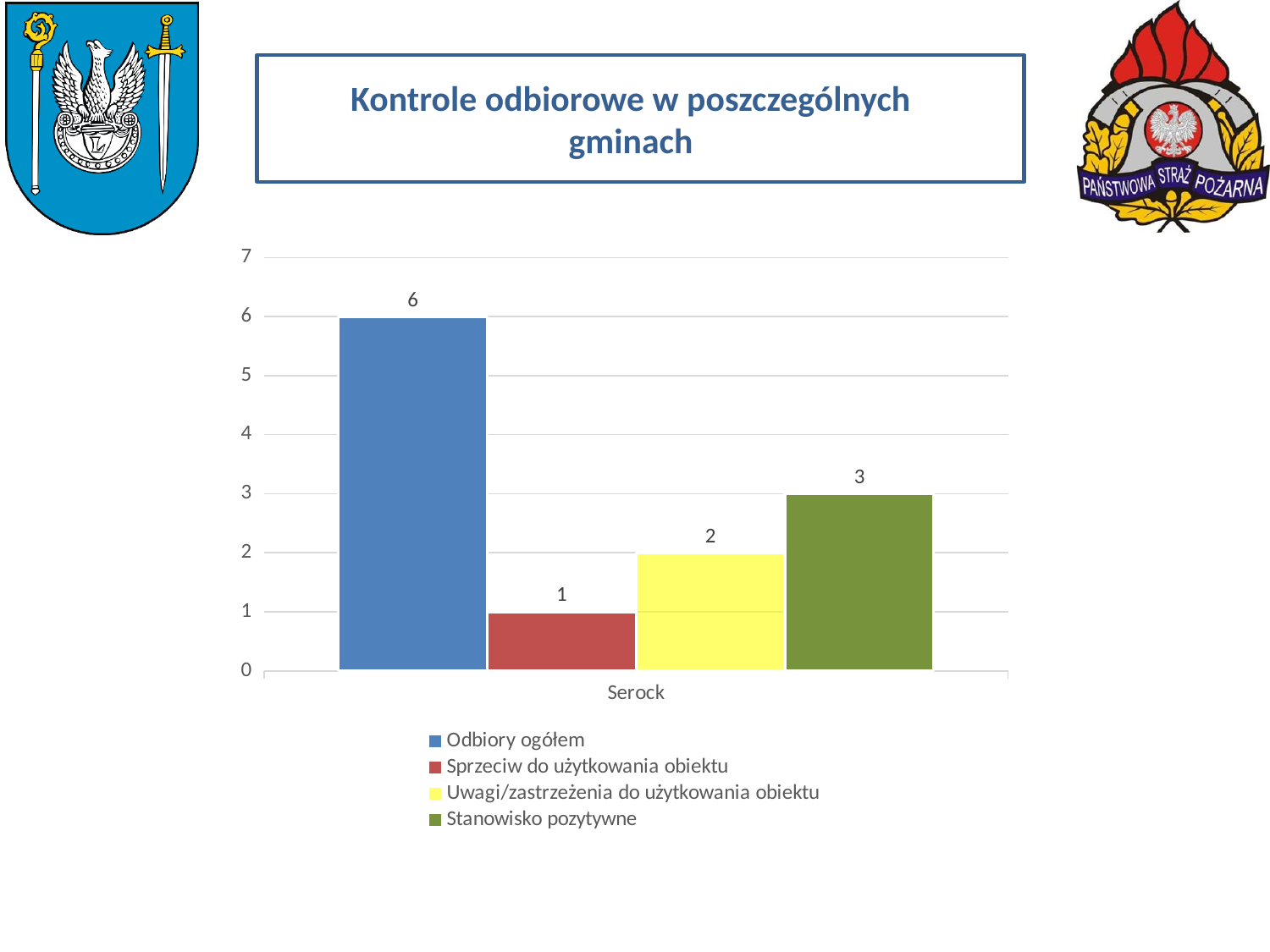
What is the difference between "Odbiory ogółem" and "Stanowisko pozytywne" for Serock? 3 Which series has the lowest value for Serock? Sprzeciw do użytkowania obiektu Which is larger for Serock: "Stanowisko pozytywne" or "Uwagi/zastrzeżenia do użytkowania obiektu"? Stanowisko pozytywne What is the value of "Sprzeciw do użytkowania obiektu" for Serock? 1 What is the value of "Stanowisko pozytywne" for Serock? 3 What is the value of "Uwagi/zastrzeżenia do użytkowania obiektu" for Serock? 2 What is the value of "Odbiory ogółem" for Serock? 6 Which series has the highest value for Serock? Odbiory ogółem What is the title of the chart? Kontrole odbiorowe w poszczególnych gminach How many series does the legend list? 4 What kind of chart is shown on the slide? Bar chart What colour is the bar for "Stanowisko pozytywne"? Green